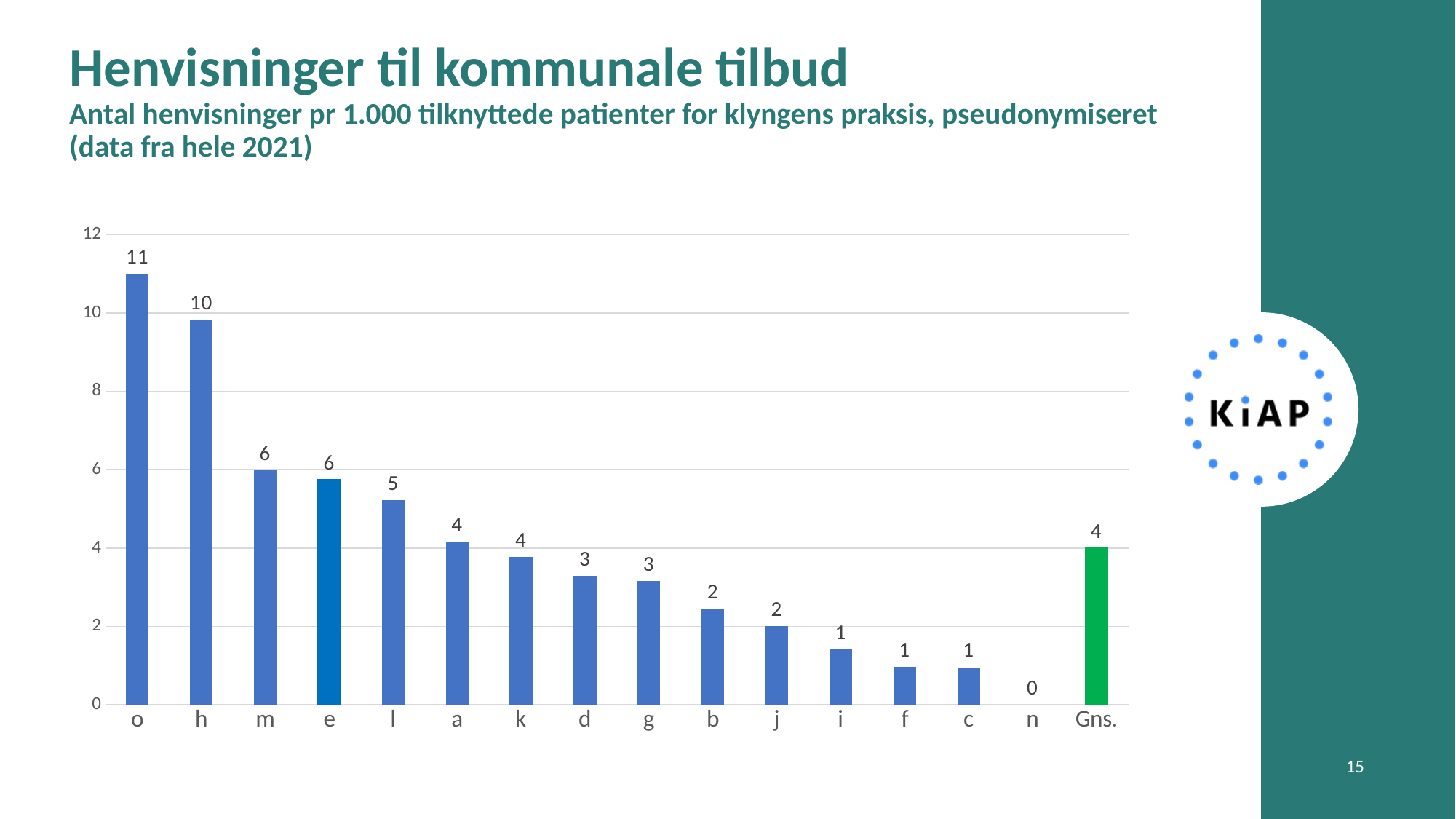
Which is larger, the value for o or the value for h? o Which category has the lowest value? n What is the value shown for category o? 11 Which category's bar is coloured green? Gns. Do the values for the practices (o through n) rise or fall from left to right? fall What is the value shown for category h? 10 What is the value shown for Gns.? 4 What is the difference between the labelled values for o and h? 1 Which category has the highest value? o How many categories are shown on the x axis? 16 Is the value for l greater or less than 4? greater What kind of chart is shown on the slide? bar chart